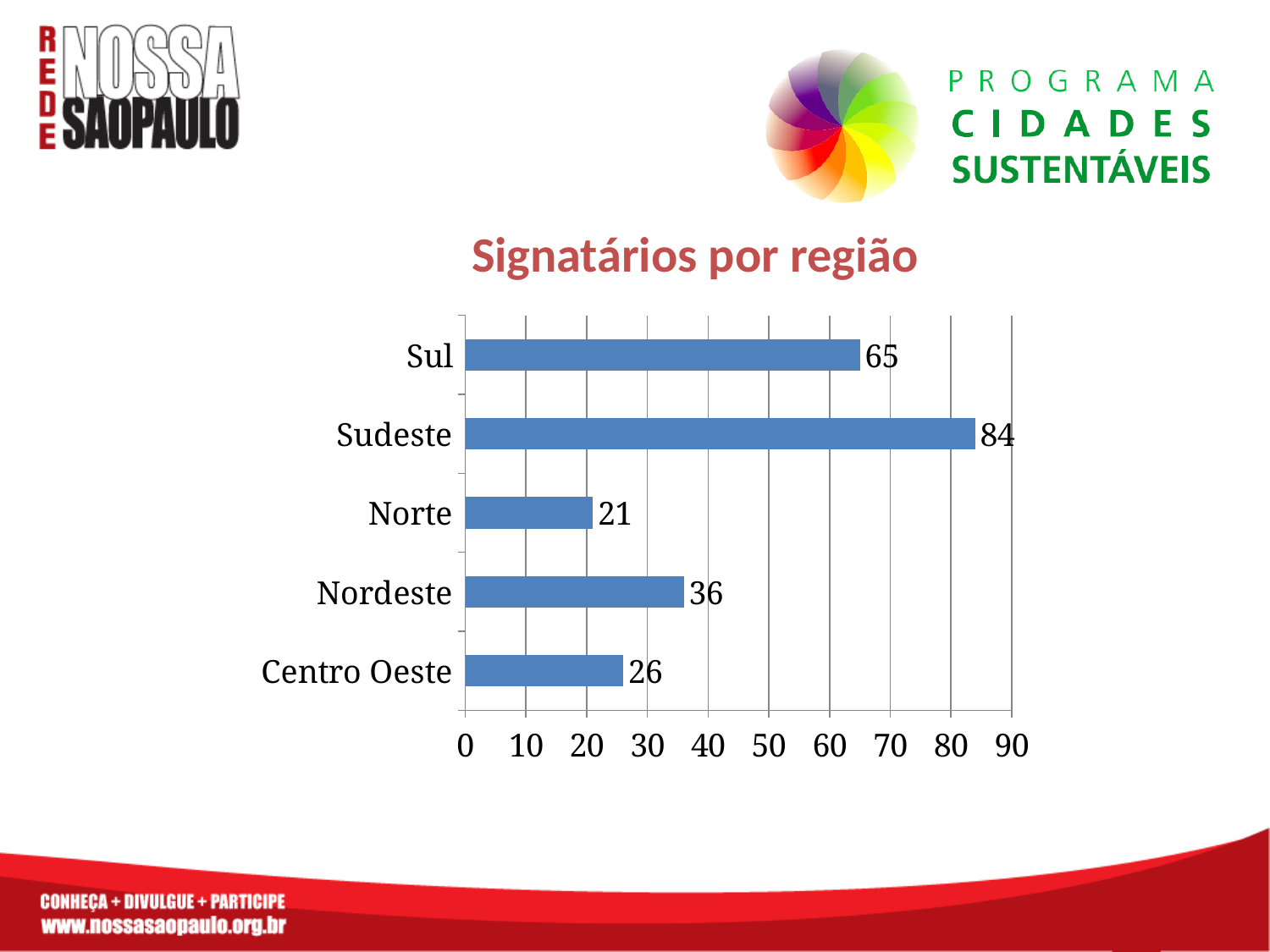
What is the value for Centro Oeste? 26 Which is larger, the value for Nordeste or the value for Norte? Nordeste What is the title of the chart? Signatários por região What is the difference between the values for Nordeste and Centro Oeste? 10 Which region has the lowest value? Norte What is the difference between the values for Sudeste and Sul? 19 What is the value for Norte? 21 What kind of chart is shown on the slide? bar chart What is the value for Sudeste? 84 How many regions are shown in the chart? 5 Which region has the highest value? Sudeste Is the value for Sul greater or less than 60? greater